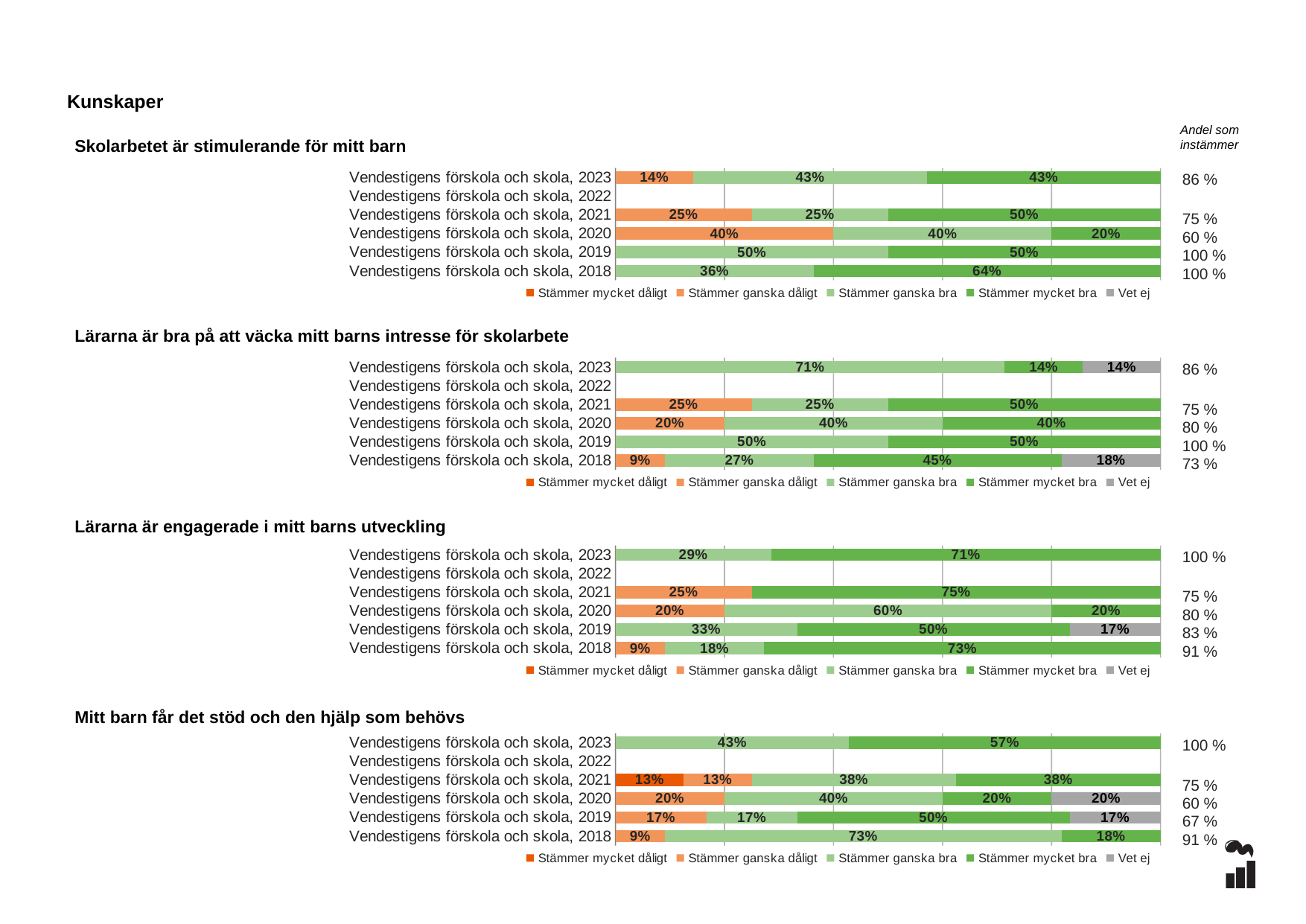
In the chart 'Lärarna är engagerade i mitt barns utveckling', what is the 'Stämmer mycket bra' value for Vendestigens förskola och skola, 2021? 75% In the chart 'Mitt barn får det stöd och den hjälp som behövs', which is larger for 2023: 'Stämmer ganska bra' or 'Stämmer mycket bra'? Stämmer mycket bra In the chart 'Mitt barn får det stöd och den hjälp som behövs', what is the 'Stämmer mycket dåligt' value for Vendestigens förskola och skola, 2021? 13% In the chart 'Lärarna är engagerade i mitt barns utveckling', what is the difference between the 'Stämmer mycket bra' value for 2023 and the 'Stämmer ganska bra' value for 2023? 42% What kind of chart is 'Lärarna är engagerade i mitt barns utveckling'? Stacked bar chart How many series does the legend list in the chart 'Skolarbetet är stimulerande för mitt barn'? 5 In the chart 'Lärarna är bra på att väcka mitt barns intresse för skolarbete', what is the 'Vet ej' value for Vendestigens förskola och skola, 2018? 18% In the chart 'Mitt barn får det stöd och den hjälp som behövs', what is the 'Andel som instämmer' value for Vendestigens förskola och skola, 2019? 67 % In the chart 'Skolarbetet är stimulerande för mitt barn', what is the 'Stämmer mycket bra' value for Vendestigens förskola och skola, 2018? 64% How many category rows (years) are shown in the chart 'Mitt barn får det stöd och den hjälp som behövs'? 6 In the chart 'Skolarbetet är stimulerande för mitt barn', what is the 'Stämmer ganska dåligt' value for Vendestigens förskola och skola, 2020? 40% In the chart 'Lärarna är bra på att väcka mitt barns intresse för skolarbete', what is the 'Stämmer ganska bra' value for Vendestigens förskola och skola, 2023? 71%